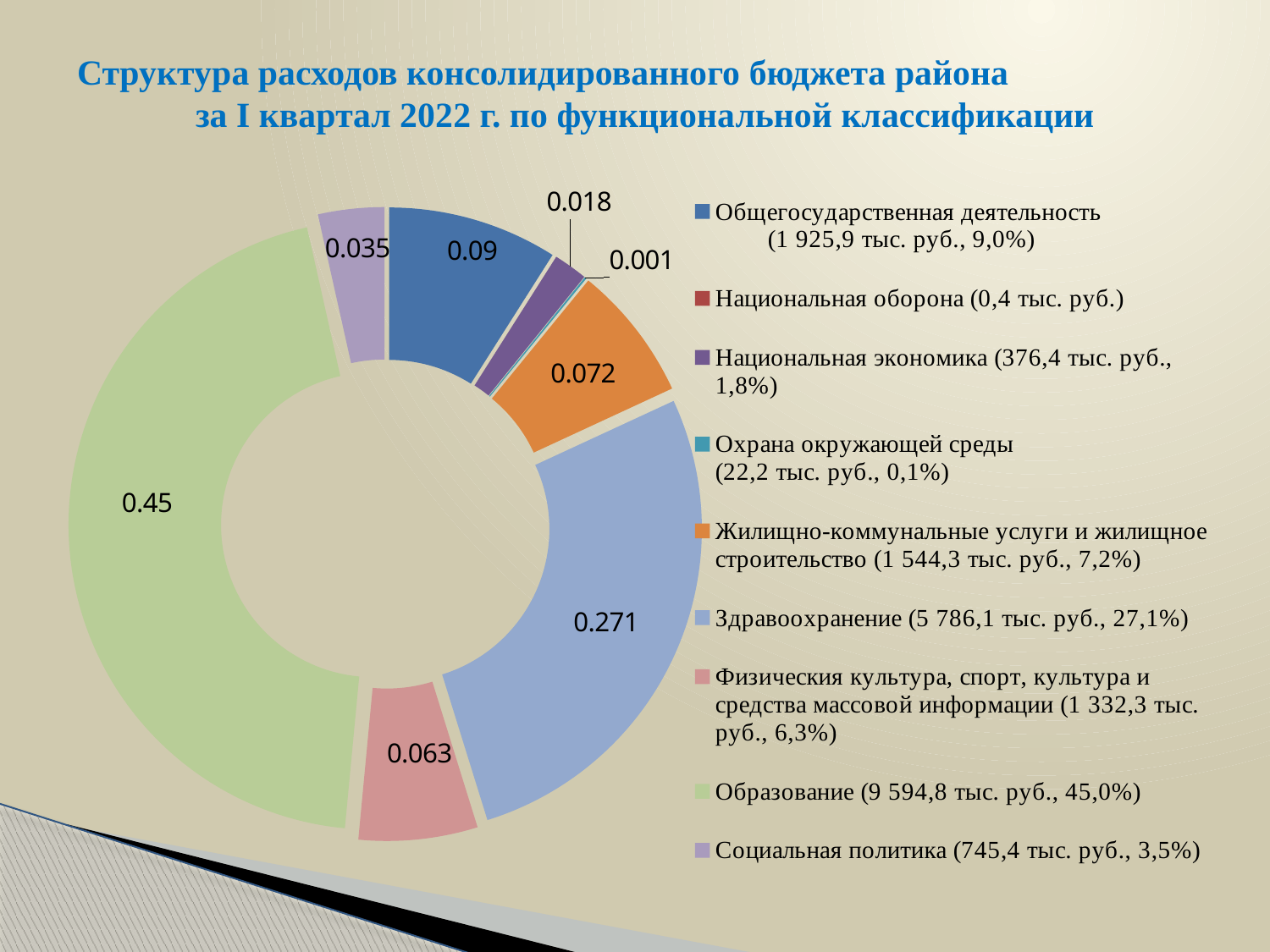
What is the data label on the slice for Общегосударственная деятельность? 0.09 What is the data label on the slice for Социальная политика? 0.035 According to the legend, what amount in тыс. руб. is given for Образование? 9 594,8 тыс. руб. Which category has the largest slice in the chart? Образование What is the data label on the slice for Здравоохранение? 0.271 Which of the two is larger: the slice for Здравоохранение or the slice for Физическая культура, спорт, культура и средства массовой информации? Здравоохранение What is the data label on the slice for Жилищно-коммунальные услуги и жилищное строительство? 0.072 How many entries does the legend list? 9 What is the difference between the data labels for Образование (0.45) and Здравоохранение (0.271)? 0.179 What is the data label on the slice for Образование? 0.45 What kind of chart is shown on the slide? Doughnut (pie) chart What colour is the slice for Жилищно-коммунальные услуги и жилищное строительство? Orange